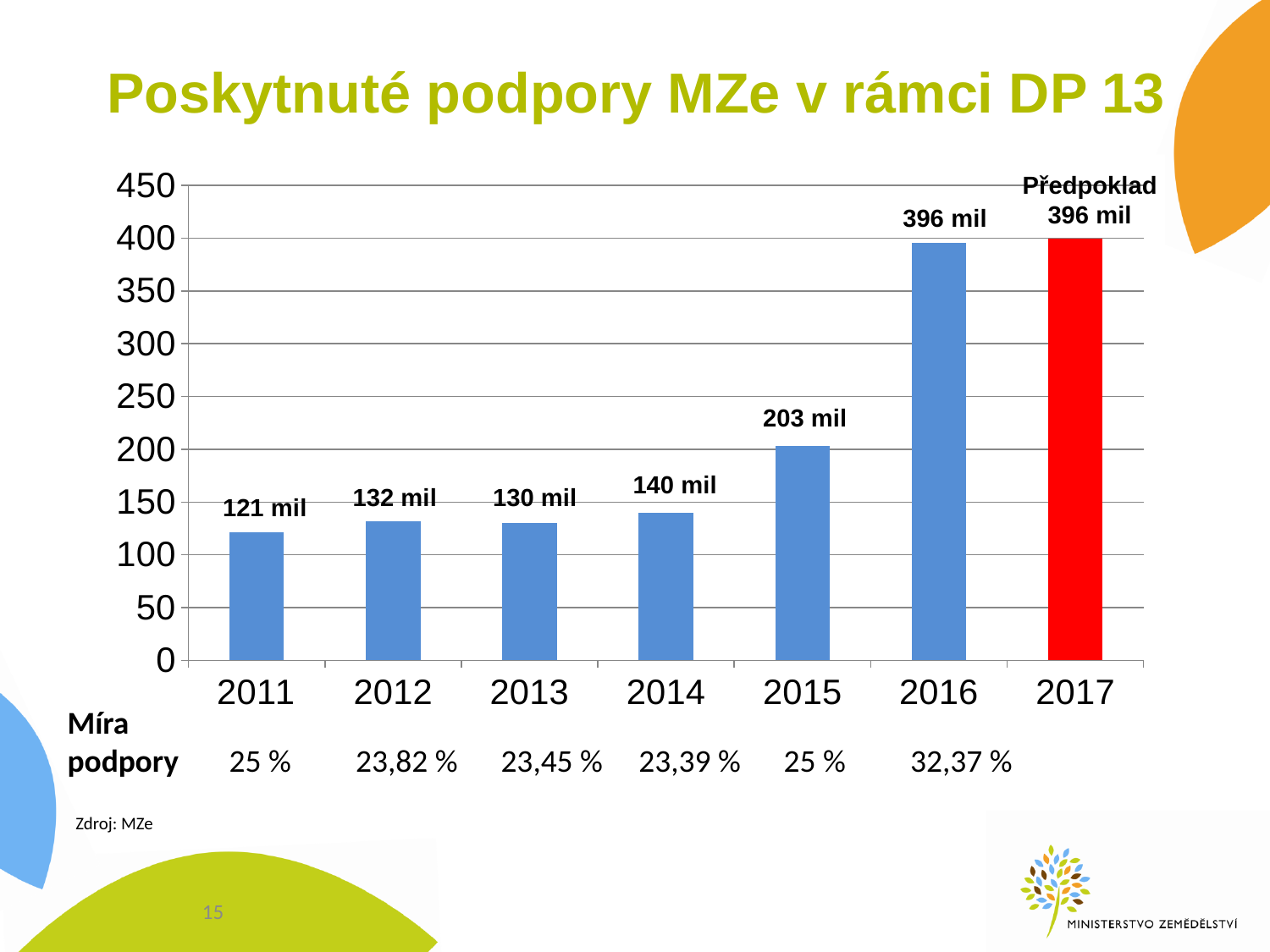
Do the values rise or fall from 2014 to 2016? rise How many years are shown on the x axis? 7 Which year has the lowest value? 2011 What is the value for 2014? 140 mil Which is larger, the value for 2012 or the value for 2014? 2014 What is the difference between the values for 2016 and 2015? 193 mil What is the title of the chart? Poskytnuté podpory MZe v rámci DP 13 What kind of chart is shown on the slide? bar chart What is the value for 2011? 121 mil What is the difference between the values for 2012 and 2013? 2 mil Is the value for 2015 greater or less than 250? less What is the value for 2015? 203 mil